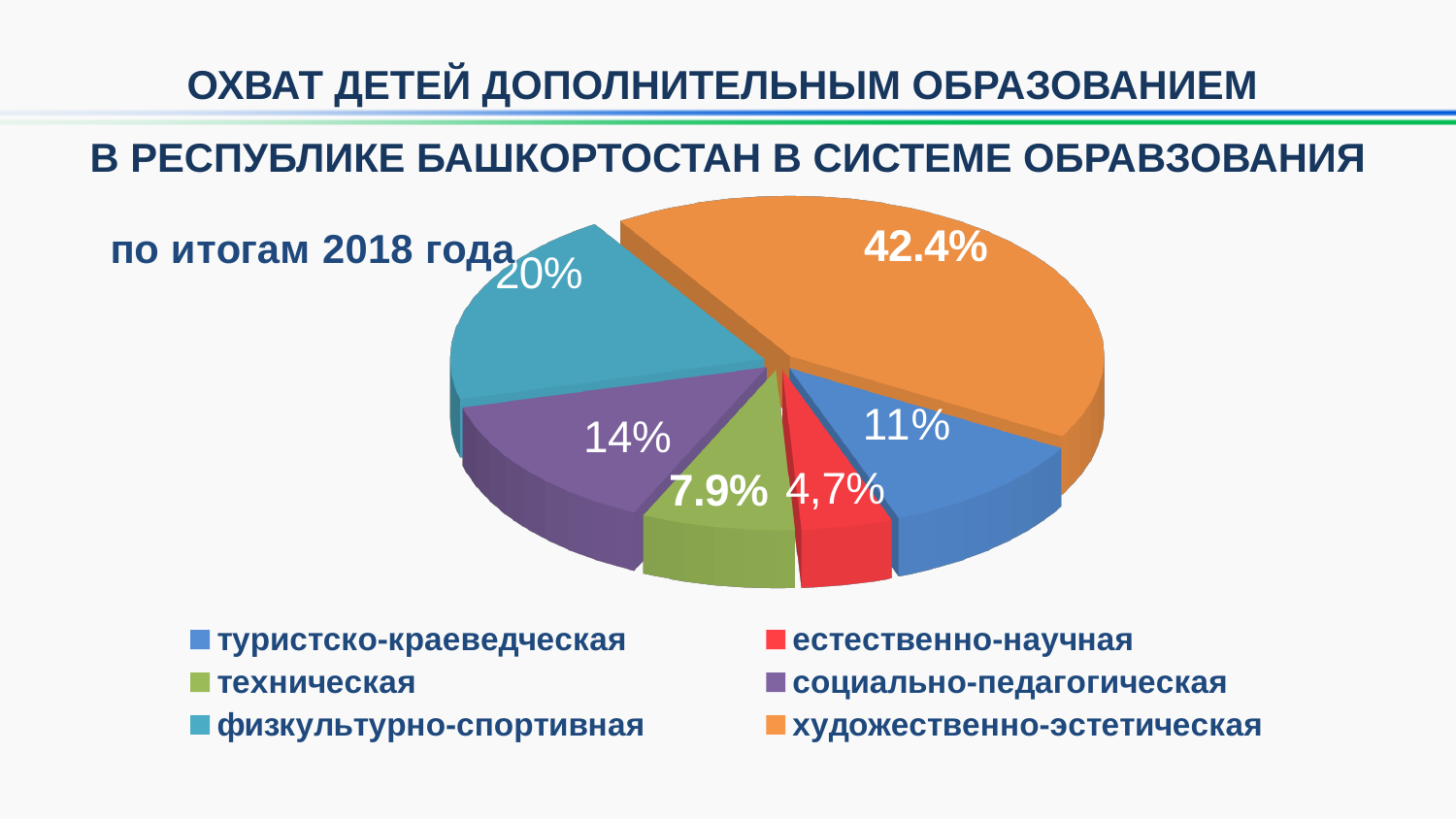
Which category has the smallest share of the pie? естественно-научная What kind of chart is shown on the slide? pie chart What percentage is shown for социально-педагогическая? 14% What percentage is shown for туристско-краеведческая? 11% What percentage is shown for физкультурно-спортивная? 20% How many slices does the pie chart have? 6 Which category has the largest share of the pie? художественно-эстетическая What percentage is shown for художественно-эстетическая? 42.4% What percentage is shown for естественно-научная? 4,7% By how many percentage points does художественно-эстетическая exceed физкультурно-спортивная? 22.4 What colour is the slice for техническая? green Which is larger, the share for техническая or the share for социально-педагогическая? социально-педагогическая